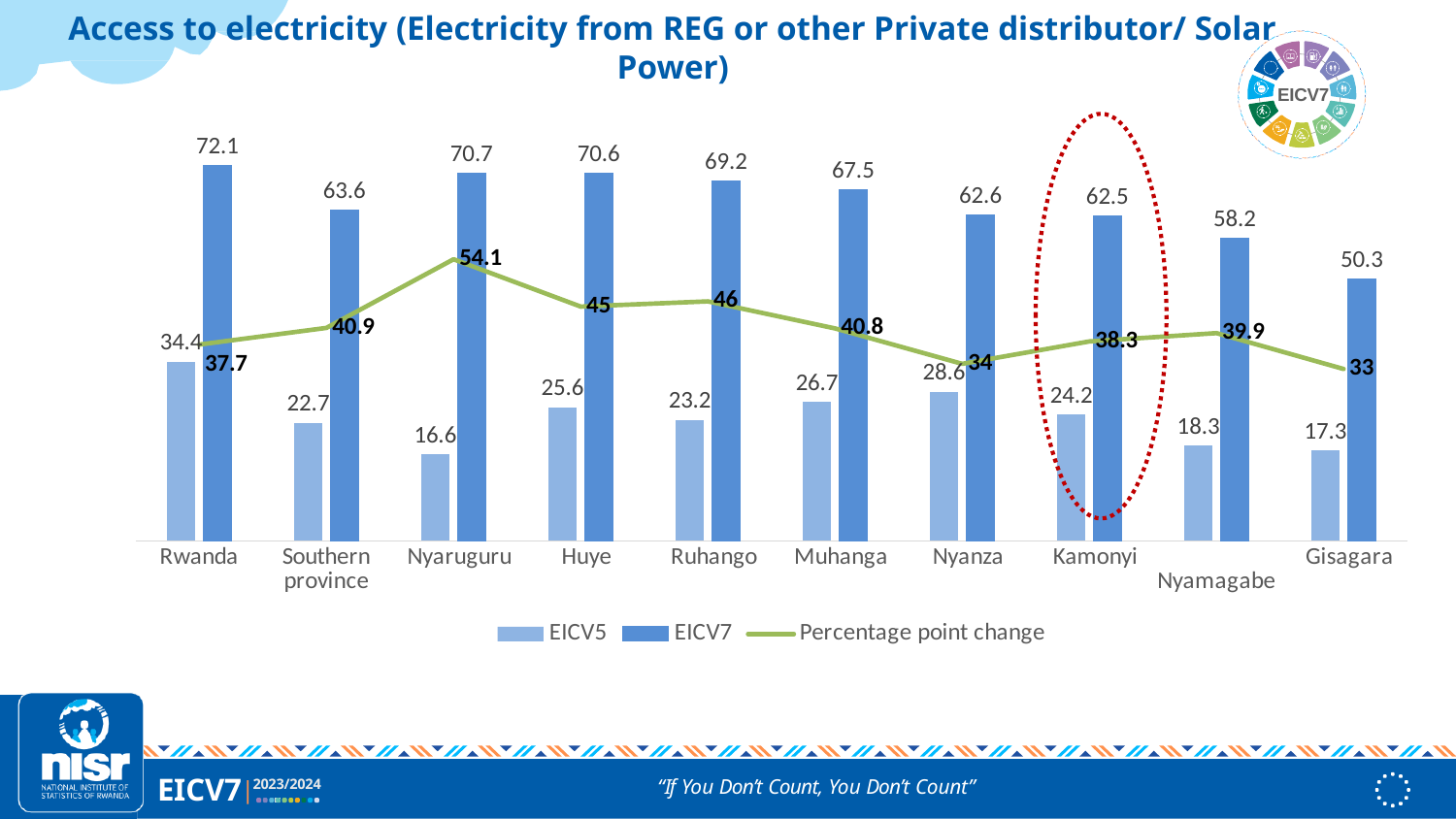
What is the EICV7 value for Nyaruguru? 70.7 How many categories are shown on the x axis? 10 How many series does the legend list? 3 What is the EICV5 value for Kamonyi? 24.2 Which category is highlighted with a red dotted oval? Kamonyi Which category has the lowest EICV7 value? Gisagara Which is larger, the EICV5 value for Nyanza or the EICV5 value for Muhanga? Nyanza What is the difference between the EICV7 and EICV5 values for Nyamagabe? 39.9 Which category has the highest EICV7 value? Rwanda Which category has the highest percentage point change? Nyaruguru What is the percentage point change shown for Huye? 45 Which category has the lowest EICV5 value? Nyaruguru